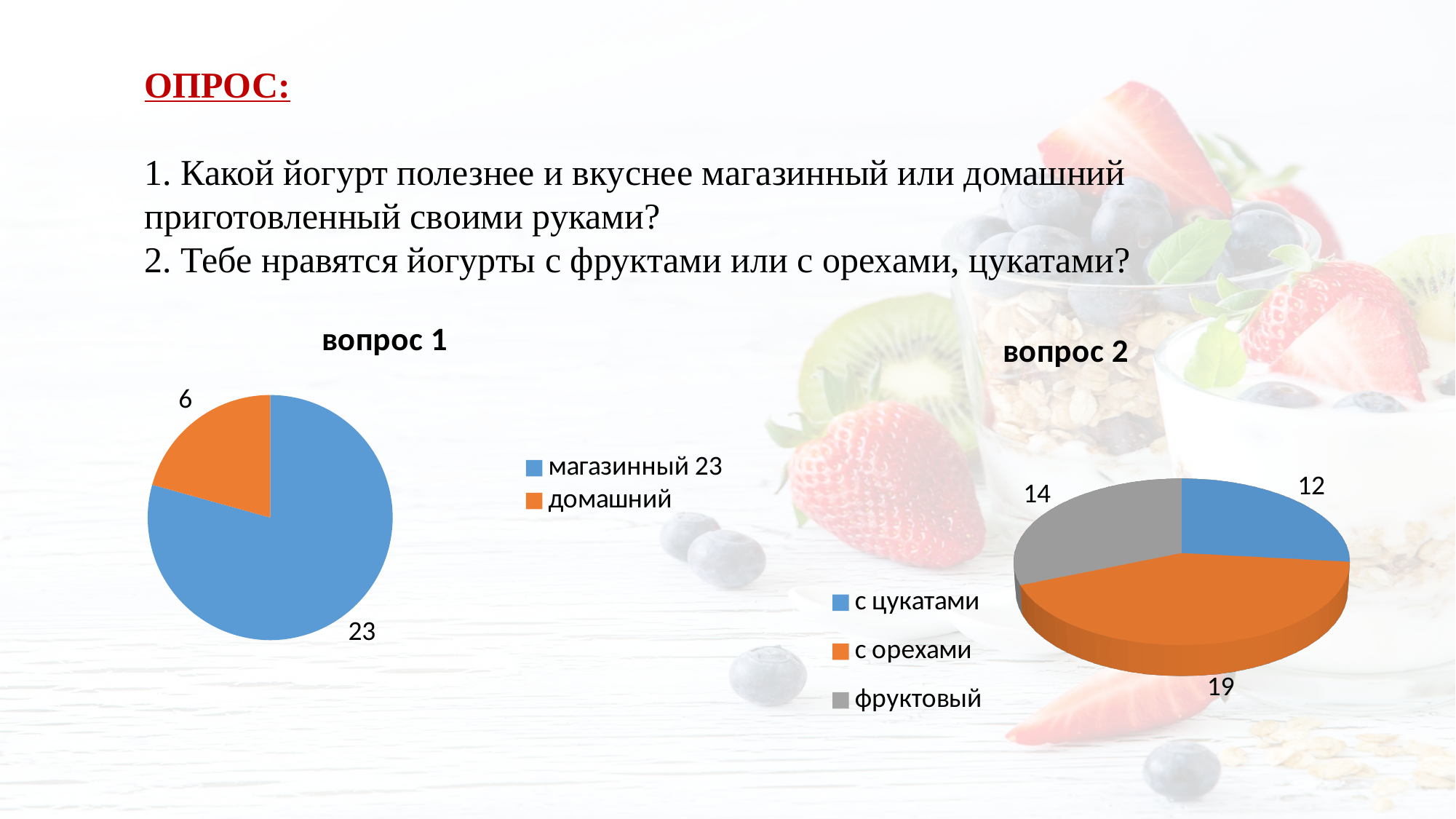
In the chart titled "вопрос 1", what is the value for "магазинный"? 23 In the chart titled "вопрос 2", what is the value for "фруктовый"? 14 In the chart titled "вопрос 1", what is the total of all slices? 29 In the chart titled "вопрос 1", which category has the largest slice? магазинный In the chart titled "вопрос 1", what is the difference between the values for "магазинный" and "домашний"? 17 In the chart titled "вопрос 2", how many categories does the legend list? 3 What kind of chart is the chart titled "вопрос 2"? pie chart In the chart titled "вопрос 2", which category has the smallest slice? с цукатами In the chart titled "вопрос 2", what is the difference between the values for "с орехами" and "с цукатами"? 7 In the chart titled "вопрос 2", what is the value for "с орехами"? 19 In the chart titled "вопрос 1", what is the value for "домашний"? 6 In the chart titled "вопрос 2", which is larger, the value for "с орехами" or the value for "фруктовый"? с орехами